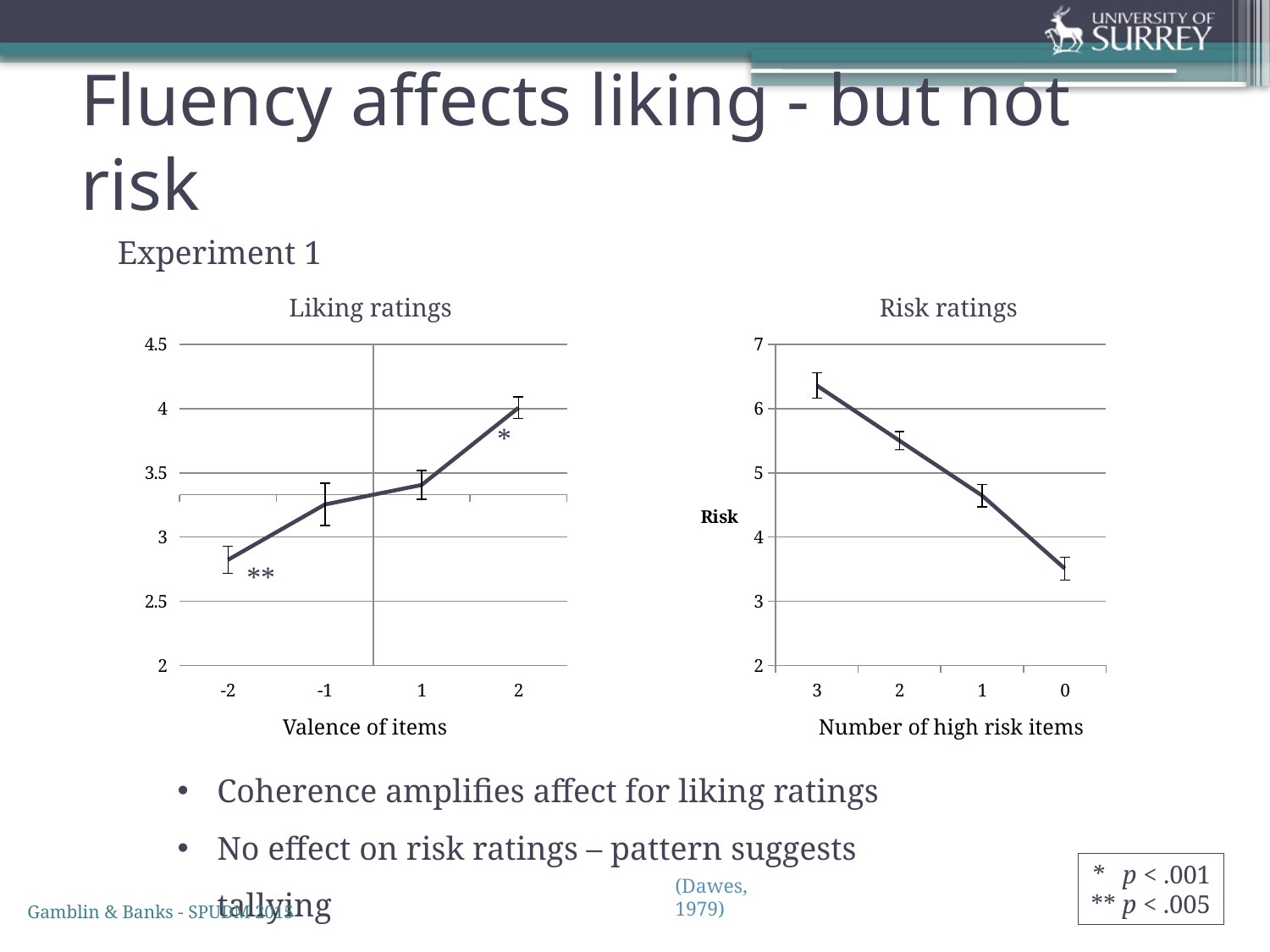
What is the x-axis label of the Risk ratings chart? Number of high risk items In the Liking ratings chart, which valence of items has the highest liking rating? 2 In the Risk ratings chart, which number of high risk items has the lowest risk rating? 0 What kind of chart is the Liking ratings chart? line chart In the Liking ratings chart, is the value for valence -2 greater or less than 3? less In the Risk ratings chart, is the value for 0 high risk items greater or less than 4? less In the Risk ratings chart, is the value for 3 high risk items greater or less than 6? greater In the Liking ratings chart, which valence of items has the lowest liking rating? -2 In the Risk ratings chart, which number of high risk items has the highest risk rating? 3 In the Liking ratings chart, do the liking ratings rise or fall as valence increases from -2 to 2? rise How many data points are plotted in the Risk ratings chart? 4